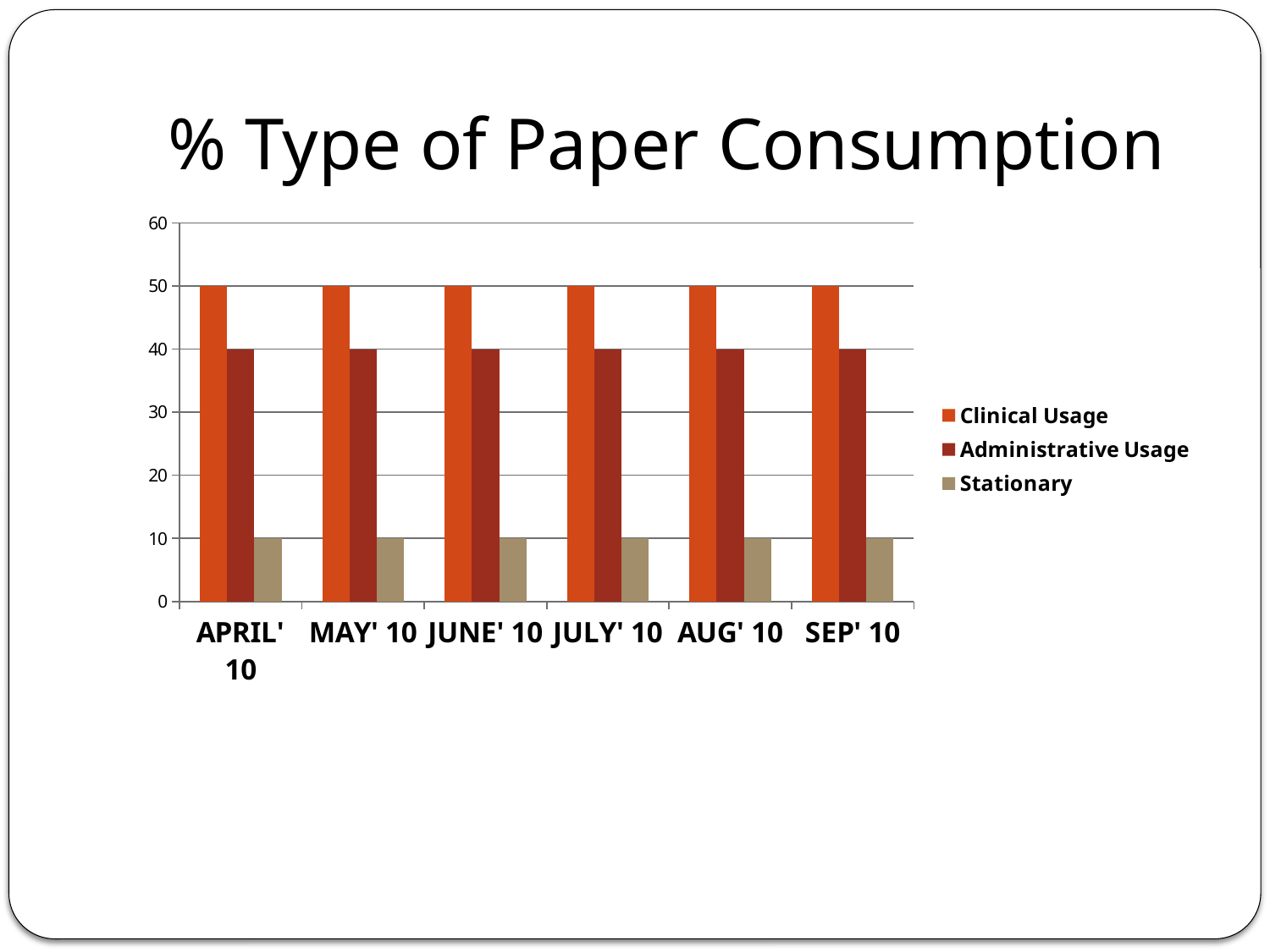
What is the value for Administrative Usage in JULY' 10? 40 How many series does the legend list? 3 Does the Clinical Usage value change from APRIL' 10 to SEP' 10? No, it stays at 50 What is the value for Clinical Usage in APRIL' 10? 50 How many months are shown on the x axis? 6 What is the difference between Clinical Usage and Administrative Usage in JUNE' 10? 10 What kind of chart is shown on the slide? bar chart What is the value for Stationary in SEP' 10? 10 Which series has the highest value in MAY' 10? Clinical Usage What is the title of the chart? % Type of Paper Consumption Which is larger in SEP' 10, Administrative Usage or Stationary? Administrative Usage Which series has the lowest value in AUG' 10? Stationary